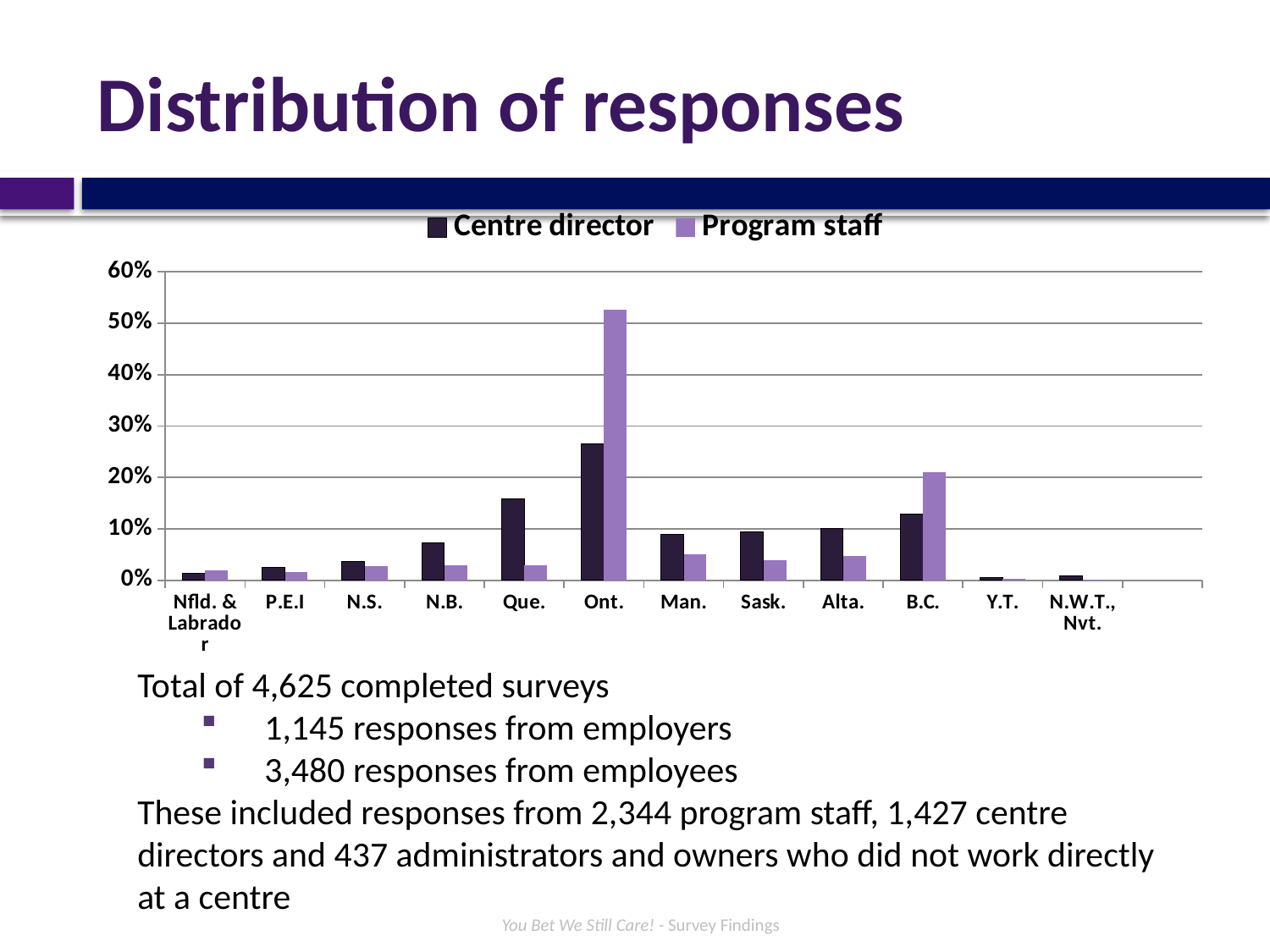
Is the Program staff value for B.C. greater or less than 30%? less Is the Program staff value for Ont. greater or less than 50%? greater Is the Centre director value for Ont. greater or less than 30%? less For B.C., which series has the larger value, Centre director or Program staff? Program staff How many provinces/territories (categories) are shown on the x axis? 12 Which series is shown in the darker purple colour? Centre director How many series does the legend list? 2 Which category has the highest Program staff value? Ont. For Que., which series has the larger value, Centre director or Program staff? Centre director Which category has the highest Centre director value? Ont. What kind of chart is shown on the slide? Bar chart